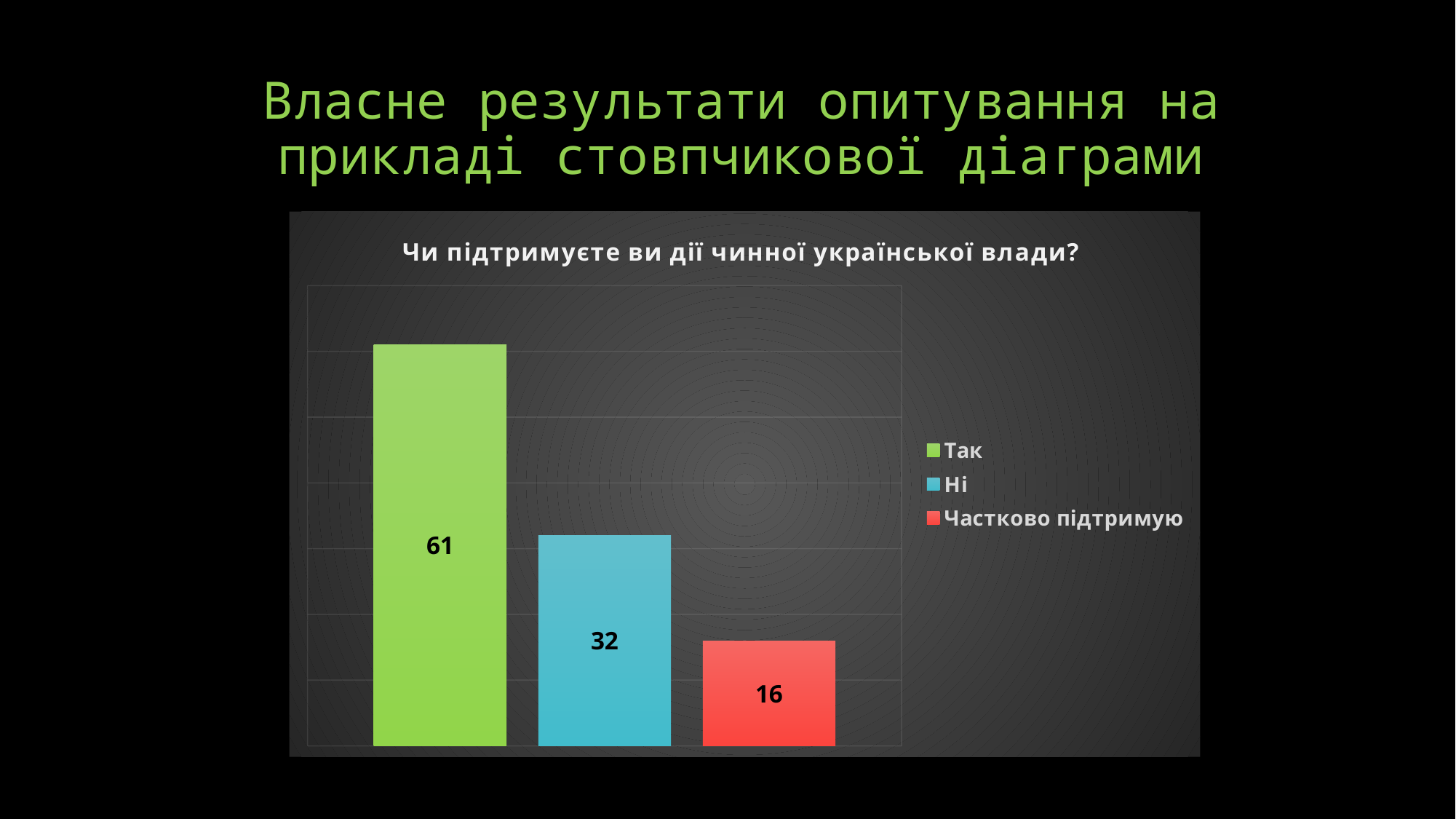
Which is larger, the value for Ні or the value for Частково підтримую? Ні What is the difference between the values for Так and Ні? 29 What is the value for Ні? 32 How many bars are plotted on the chart? 3 What is the value for Частково підтримую? 16 How many entries does the legend list? 3 Which category has the highest value? Так Which category has the lowest value? Частково підтримую What kind of chart is shown on the slide? bar chart What is the value for Так? 61 What is the title of the chart? Чи підтримуєте ви дії чинної української влади? What is the difference between the values for Ні and Частково підтримую? 16